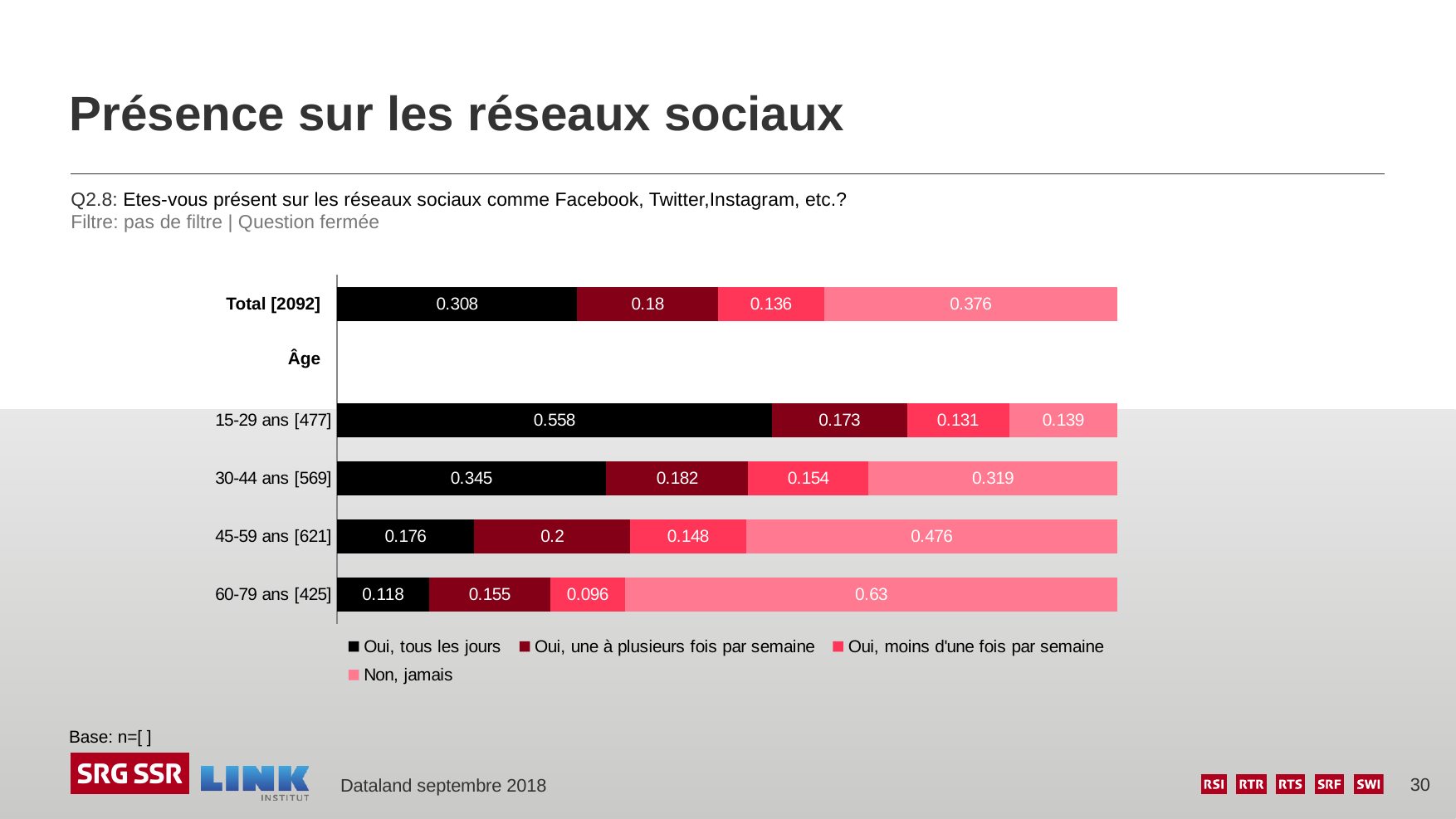
Which age group has the highest value for "Oui, tous les jours"? 15-29 ans Does the "Oui, tous les jours" value rise or fall as the age groups go from 15-29 ans to 60-79 ans? Fall What is the difference between the "Non, jamais" values for 60-79 ans and 15-29 ans? 0.491 What is the difference between the "Oui, tous les jours" values for 15-29 ans and 60-79 ans? 0.44 What is the value for "Oui, tous les jours" in the 15-29 ans age group? 0.558 What is the value for "Non, jamais" in the 60-79 ans age group? 0.63 What is the value for "Oui, une à plusieurs fois par semaine" in the Total row? 0.18 How many bars (rows) are plotted in the chart, including the Total row? 5 Which age group has the lowest value for "Oui, moins d'une fois par semaine"? 60-79 ans Which has a larger "Oui, tous les jours" value, 30-44 ans or 45-59 ans? 30-44 ans How many series does the legend list? 4 What kind of chart is shown on the slide? Stacked bar chart